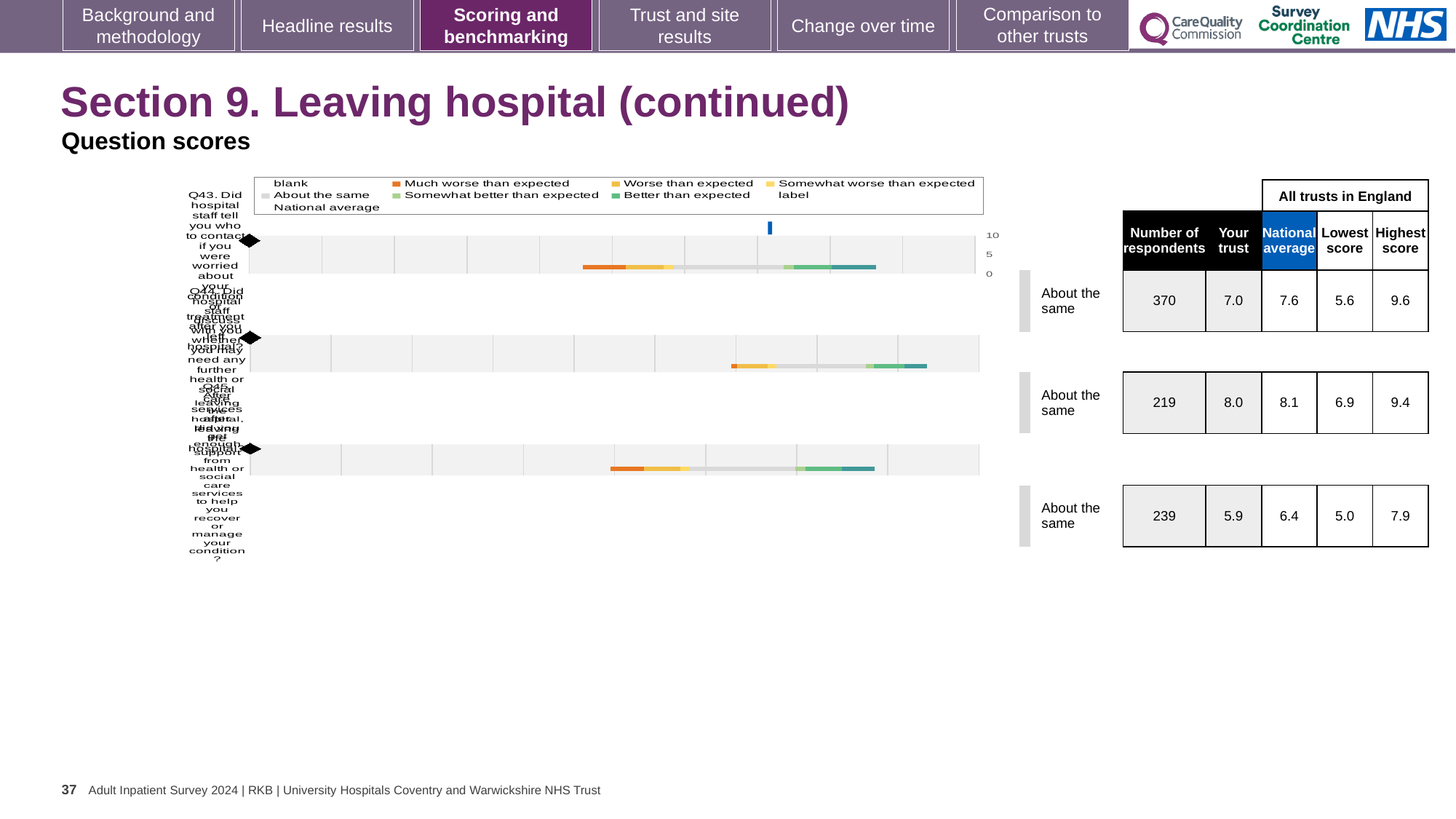
What is the 'Your trust' score for Q44 (discussing further health or social care services)? 8.0 Which question has the highest 'Your trust' score? Q44 What is the lowest score among all trusts in England for Q45? 5.0 For Q45, what is the difference between the national average and the 'Your trust' score? 0.5 What is the highest score among all trusts in England for Q43? 9.6 What benchmark rating is shown next to each of the three questions? About the same For Q43, which is larger: the 'Your trust' score or the national average? National average What kind of chart is used to show the question scores? Bar chart How many questions are plotted on the chart? 3 How many respondents are shown for Q43 (who to contact if worried after leaving hospital)? 370 What is the national average score for Q45 (enough support after leaving hospital)? 6.4 Which question has the lowest number of respondents? Q44